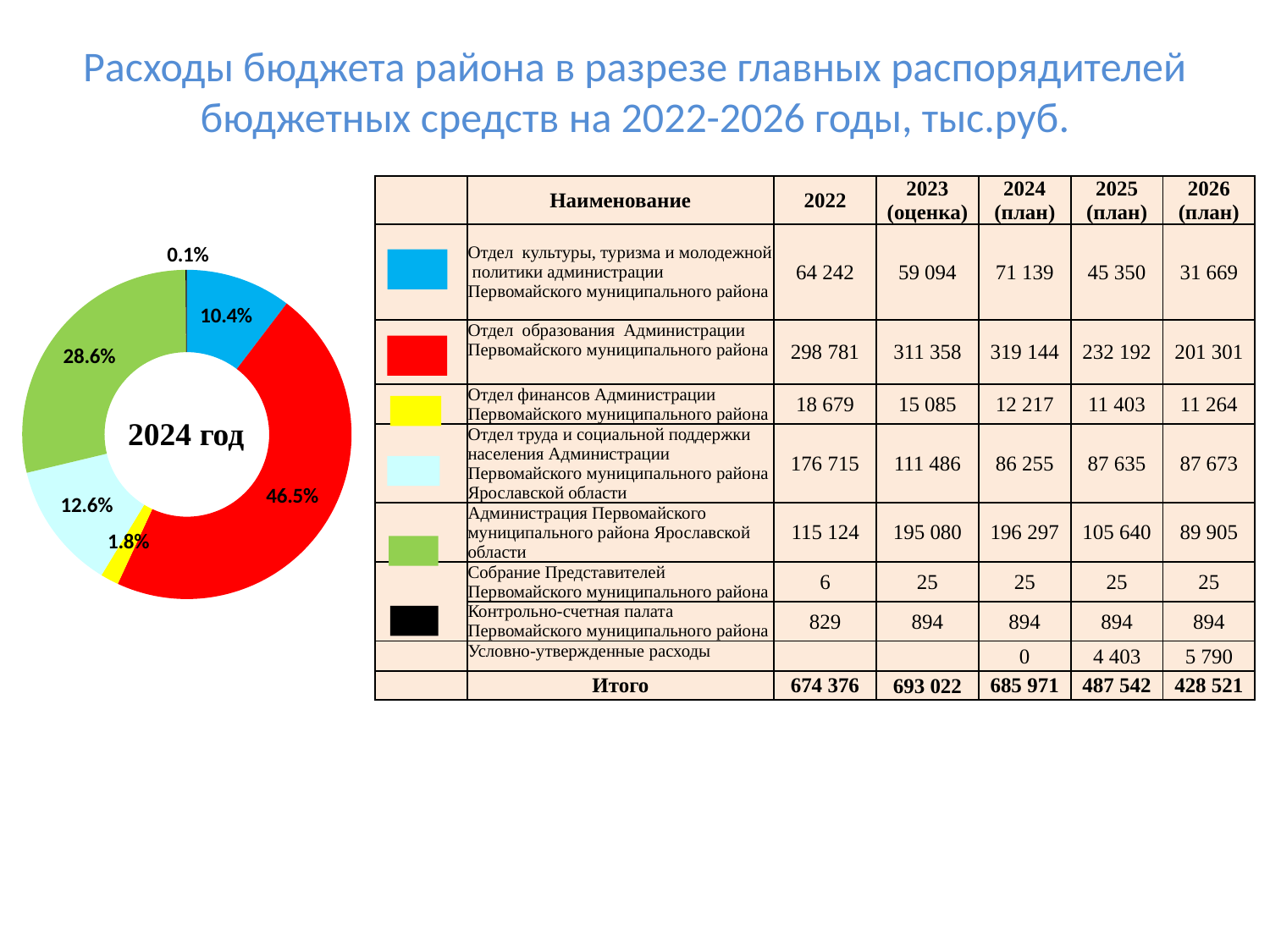
What kind of chart is shown on the slide? Donut (pie) chart How many slices are labelled on the donut chart? 6 What share of the donut chart does the light blue slice (Отдел труда и социальной поддержки населения) have? 12.6% What share of the donut chart does the blue slice (Отдел культуры, туризма и молодежной политики) have? 10.4% Which is larger on the donut chart: the light blue slice (12.6%) or the blue slice (10.4%)? The light blue slice (12.6%) What share of the donut chart does the green slice (Администрация Первомайского муниципального района) have? 28.6% Which year does the donut chart represent? 2024 год What is the difference in percentage points between the red slice (46.5%) and the green slice (28.6%) of the donut chart? 17.9 Which slice of the donut chart is the largest? 46.5% (red, Отдел образования)